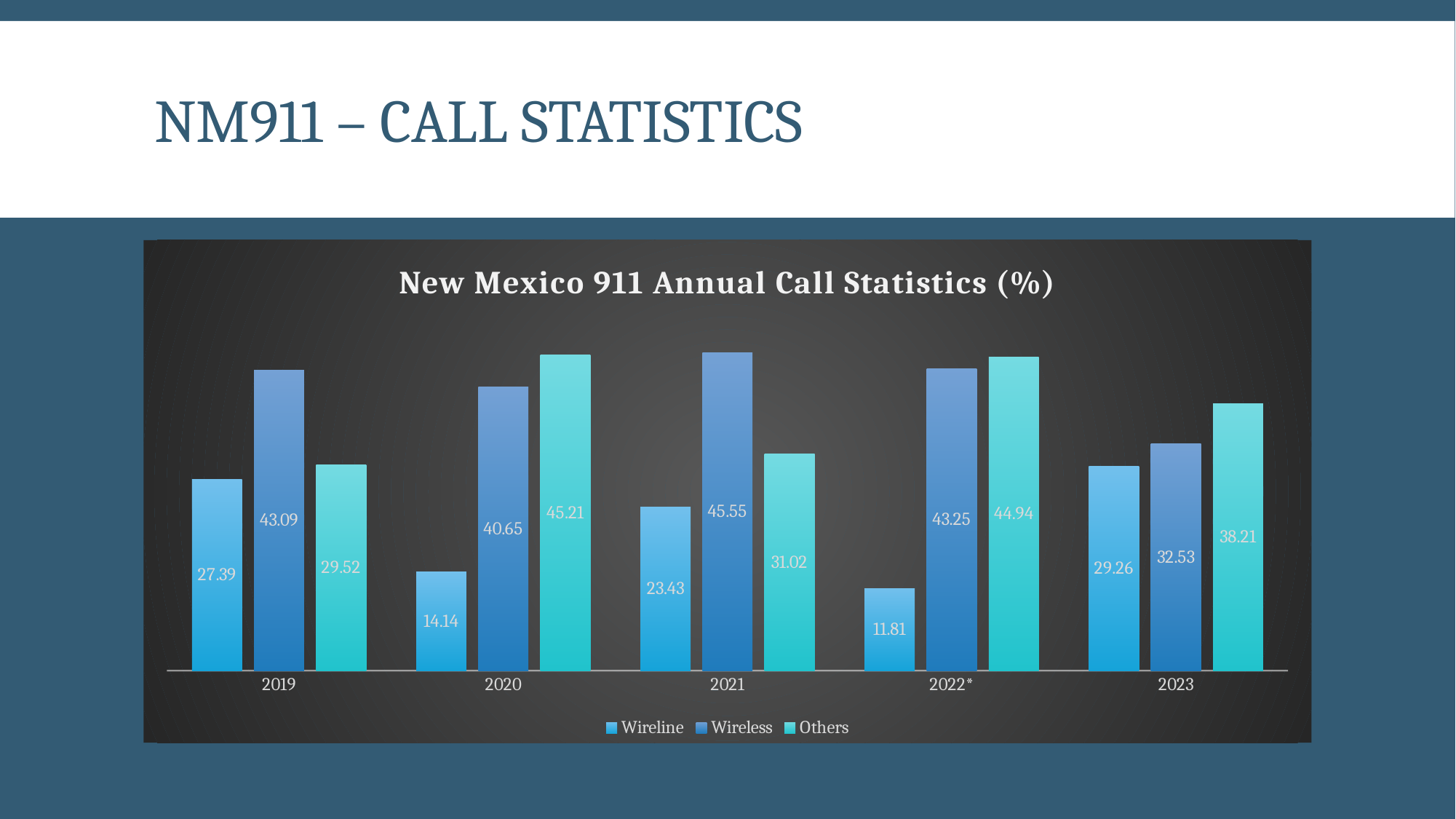
What is the title of the chart? New Mexico 911 Annual Call Statistics (%) What is the difference between the Others value and the Wireline value in 2020? 31.07 How many years are shown on the x axis? 5 What is the Wireline value for 2020? 14.14 What is the Others value for 2023? 38.21 What is the Wireless value for 2022*? 43.25 Which is larger in 2019, the Wireless value or the Others value? Wireless What is the difference between the Wireless value in 2021 and the Wireless value in 2023? 13.02 What kind of chart is shown on the slide? Bar chart Which year has the highest Wireless value? 2021 How many series does the legend list? 3 Which year has the lowest Wireline value? 2022*